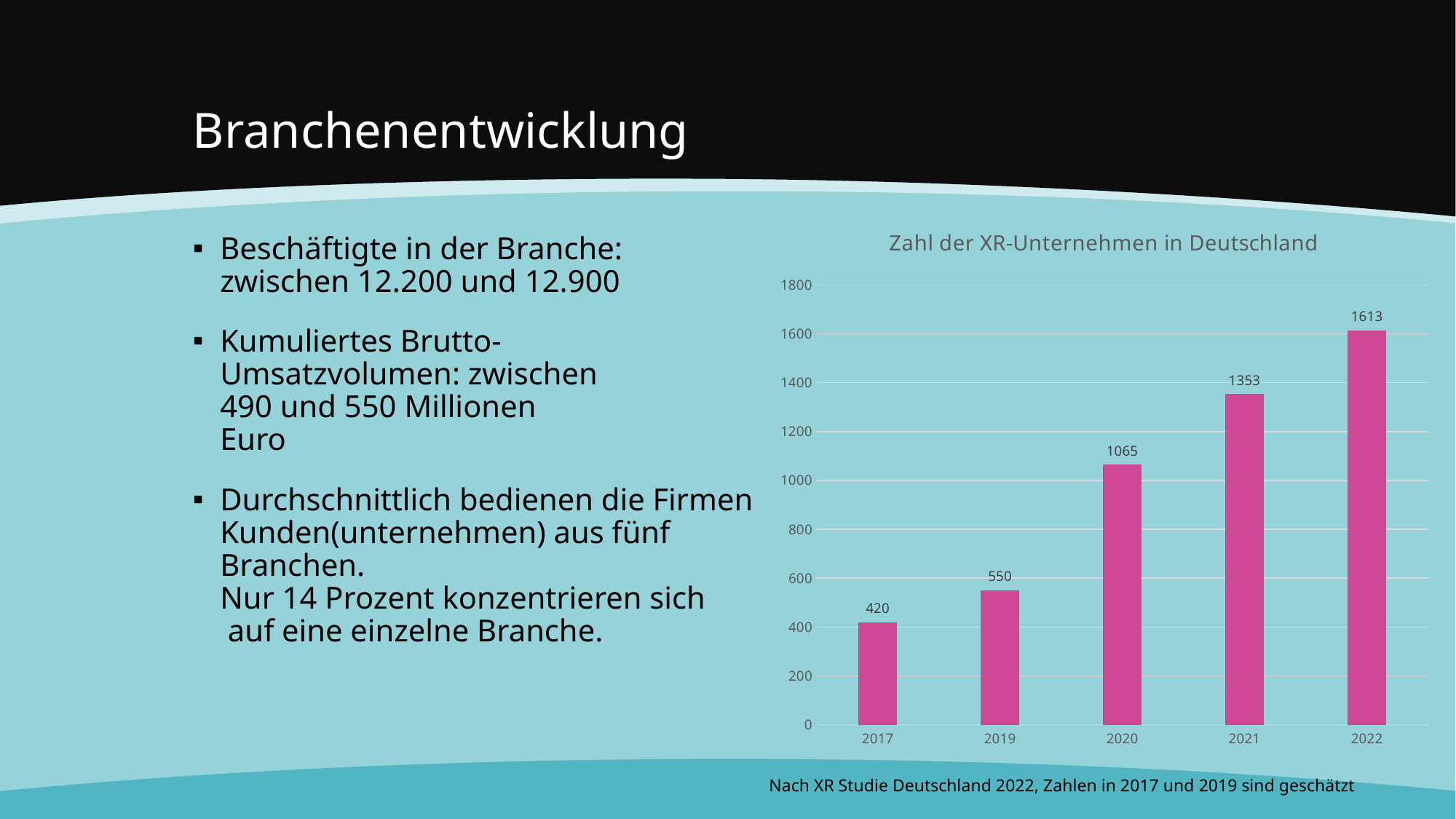
What kind of chart is shown on the slide? bar chart Do the values rise or fall from 2017 to 2022? rise How many years are shown on the x axis of the chart? 5 What is the value for 2020 in the chart? 1065 Is the value for 2021 greater or less than 1200? greater Which year has the highest number of XR companies? 2022 What is the value for 2017 in the chart? 420 Which year has the lowest number of XR companies? 2017 What is the difference between the values for 2019 and 2017? 130 What is the value for 2022 in the chart? 1613 Which is larger, the value for 2020 or the value for 2019? 2020 What is the difference between the values for 2022 and 2021? 260